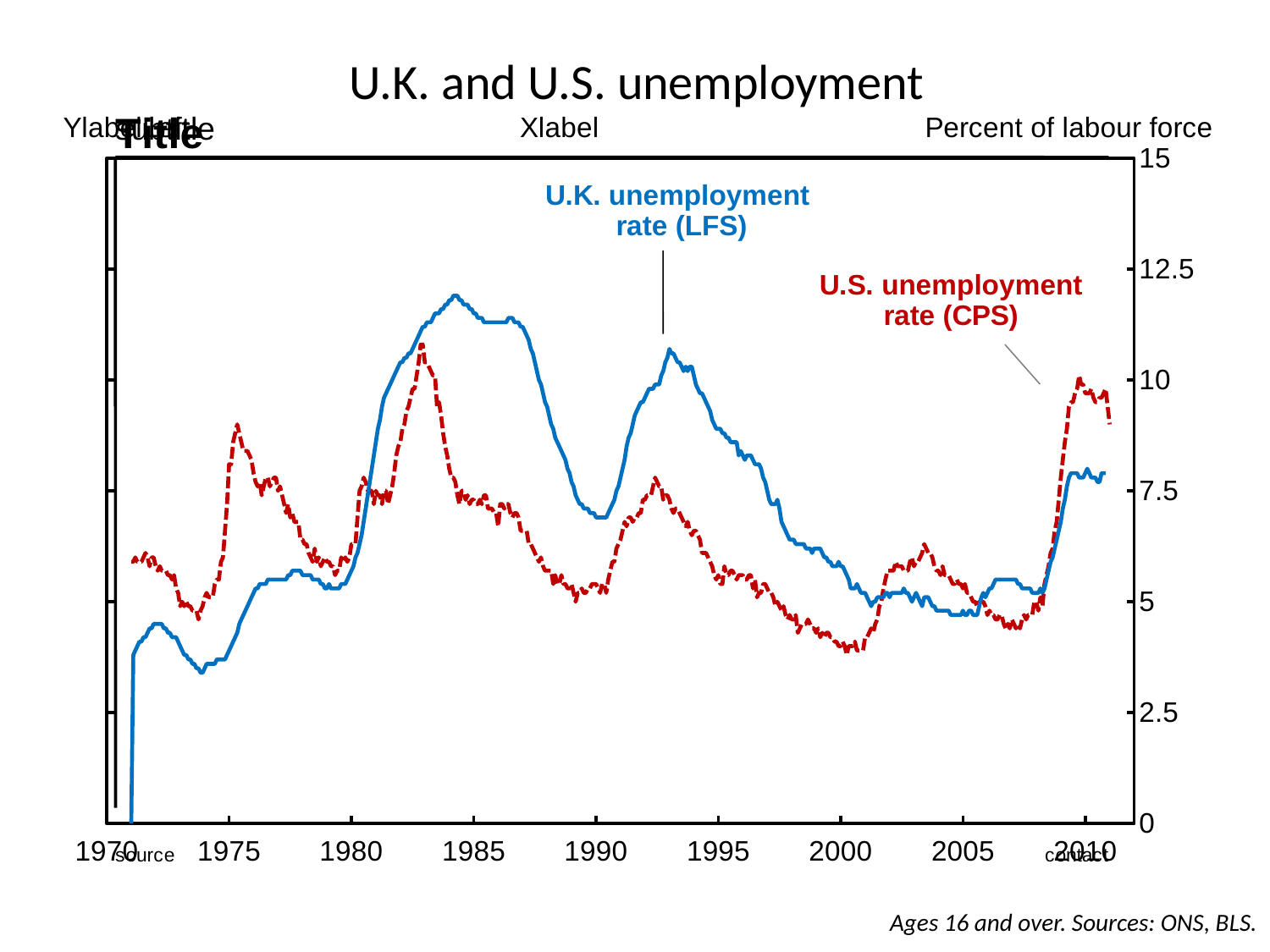
What kind of chart is shown on the slide? line chart How many series are plotted on the chart? 2 Is the peak value of the U.K. unemployment rate (LFS) around 1984 greater or less than 10? greater Is the U.K. unemployment rate (LFS) around 2005 greater or less than 7.5? less What is the title of the chart? U.K. and U.S. unemployment Around 2010, which series has the higher value, the U.K. unemployment rate (LFS) or the U.S. unemployment rate (CPS)? U.S. unemployment rate (CPS) Is the U.S. unemployment rate (CPS) around 1975 greater or less than 7.5? greater Does the U.K. unemployment rate (LFS) rise or fall between 1993 and 2000? fall Which series is drawn as a dashed line? U.S. unemployment rate (CPS) Around 1984, which series has the higher value, the U.K. unemployment rate (LFS) or the U.S. unemployment rate (CPS)? U.K. unemployment rate (LFS)